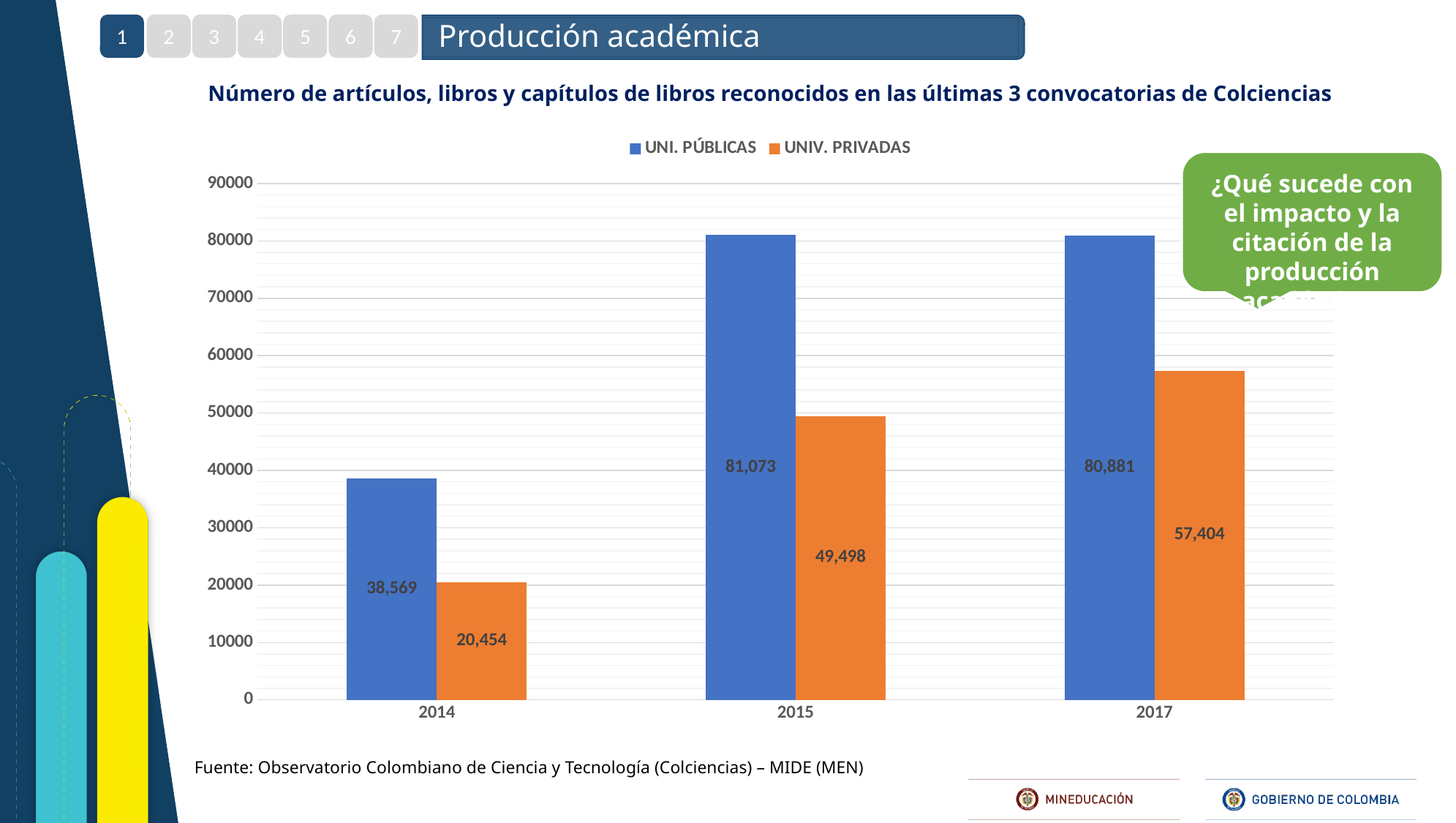
What is the difference between UNI. PÚBLICAS and UNIV. PRIVADAS in 2014? 18,115 In which year is the UNIV. PRIVADAS value lowest? 2014 What is the value for UNI. PÚBLICAS in 2014? 38,569 Which is larger in 2017: UNI. PÚBLICAS or UNIV. PRIVADAS? UNI. PÚBLICAS How many series does the legend list? 2 What is the value for UNIV. PRIVADAS in 2017? 57,404 What kind of chart is shown on the slide? Bar chart What is the value for UNIV. PRIVADAS in 2015? 49,498 Is the value for UNIV. PRIVADAS in 2015 greater or less than 40000? greater In which year is the UNI. PÚBLICAS value highest? 2015 What is the difference between the UNIV. PRIVADAS values for 2017 and 2015? 7,906 How many years are shown on the x axis? 3